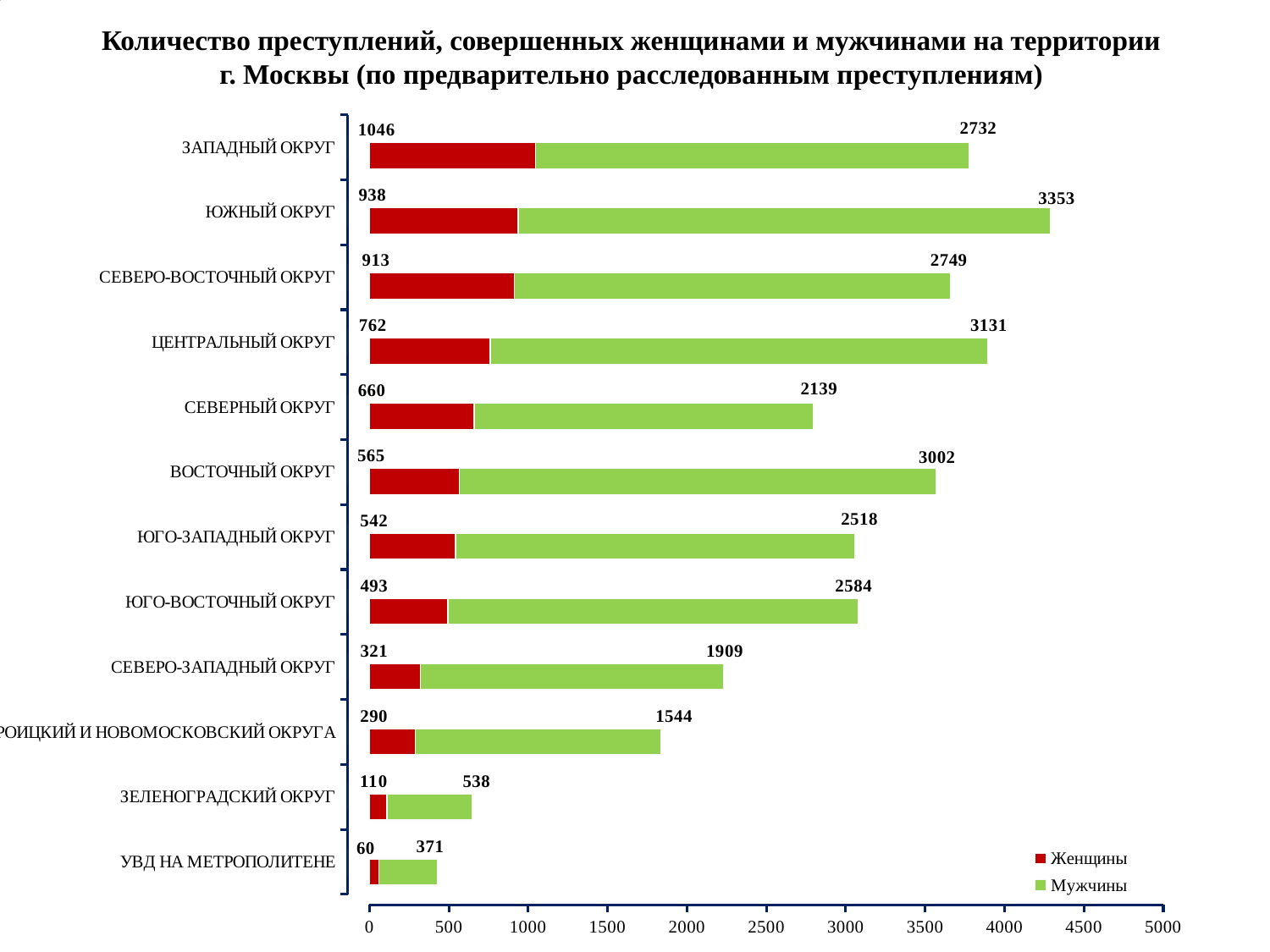
What is the difference between the Мужчины values for ЦЕНТРАЛЬНЫЙ ОКРУГ and СЕВЕРНЫЙ ОКРУГ? 992 Which series is shown in red? Женщины Which is larger: the Женщины value for СЕВЕРО-ВОСТОЧНЫЙ ОКРУГ or for ЦЕНТРАЛЬНЫЙ ОКРУГ? СЕВЕРО-ВОСТОЧНЫЙ ОКРУГ Which district has the highest value for Мужчины? ЮЖНЫЙ ОКРУГ How many series does the legend list? 2 What is the total of the stacked bar for ЮЖНЫЙ ОКРУГ? 4291 What is the value for Мужчины in ЮЖНЫЙ ОКРУГ? 3353 What is the value for Женщины in ЗАПАДНЫЙ ОКРУГ? 1046 What type of chart is shown on the slide? Stacked bar chart Which category has the lowest value for Женщины? УВД НА МЕТРОПОЛИТЕНЕ How many categories (districts) are shown on the chart? 12 What is the value for Мужчины in УВД НА МЕТРОПОЛИТЕНЕ? 371